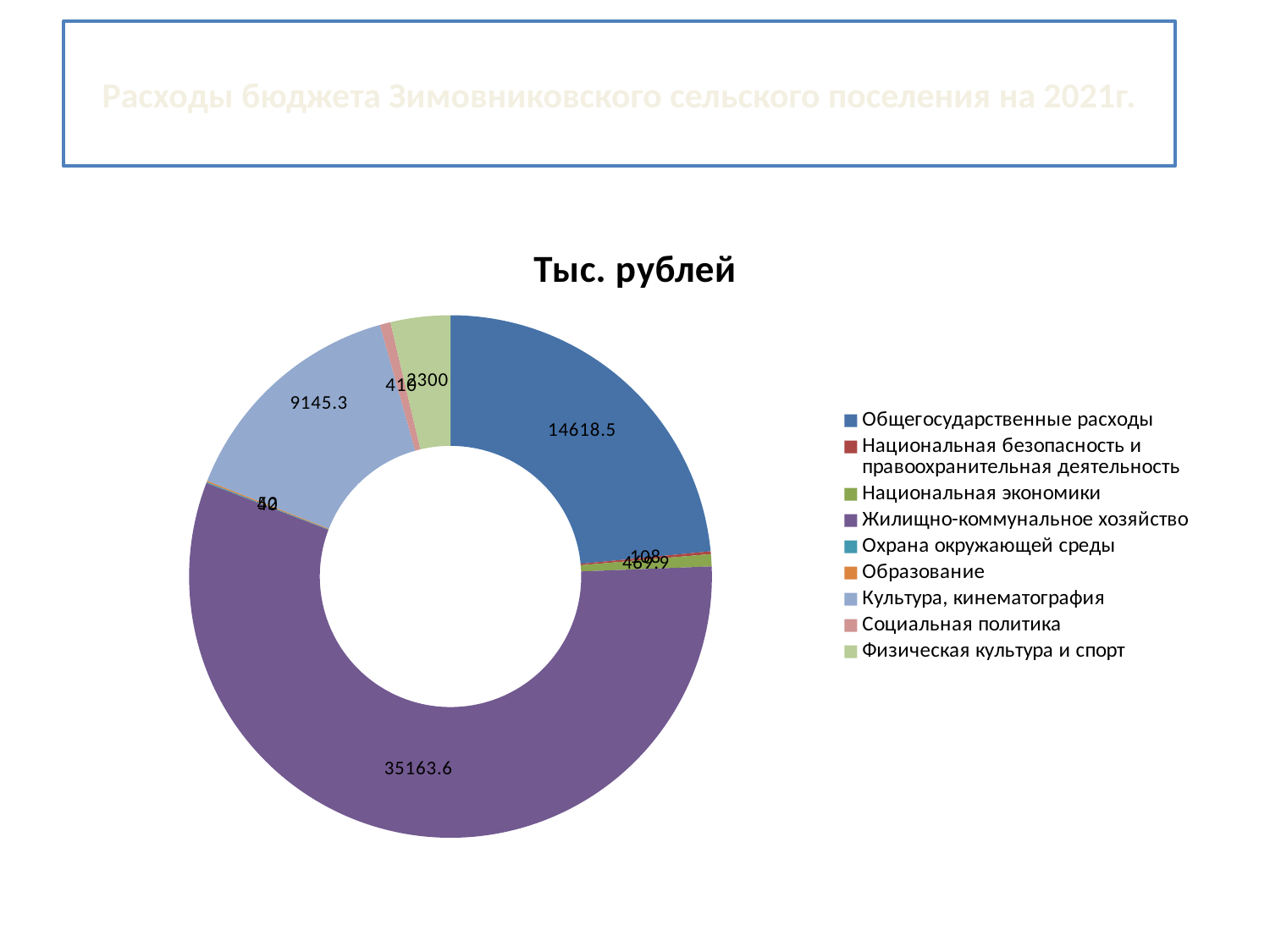
Which legend entry is shown in purple? Жилищно-коммунальное хозяйство What is the title of the chart? Тыс. рублей What kind of chart is shown on the slide? doughnut (pie) chart What is the difference between Жилищно-коммунальное хозяйство and Общегосударственные расходы? 20545.1 What is the value for Физическая культура и спорт? 2300 How many entries does the chart legend list? 9 What is the value for Жилищно-коммунальное хозяйство? 35163.6 What is the value for Культура, кинематография? 9145.3 What is the value for Общегосударственные расходы? 14618.5 Which category has the largest slice of the chart? Жилищно-коммунальное хозяйство Which is larger, Общегосударственные расходы or Культура, кинематография? Общегосударственные расходы What is the value for Национальная экономики? 469.9